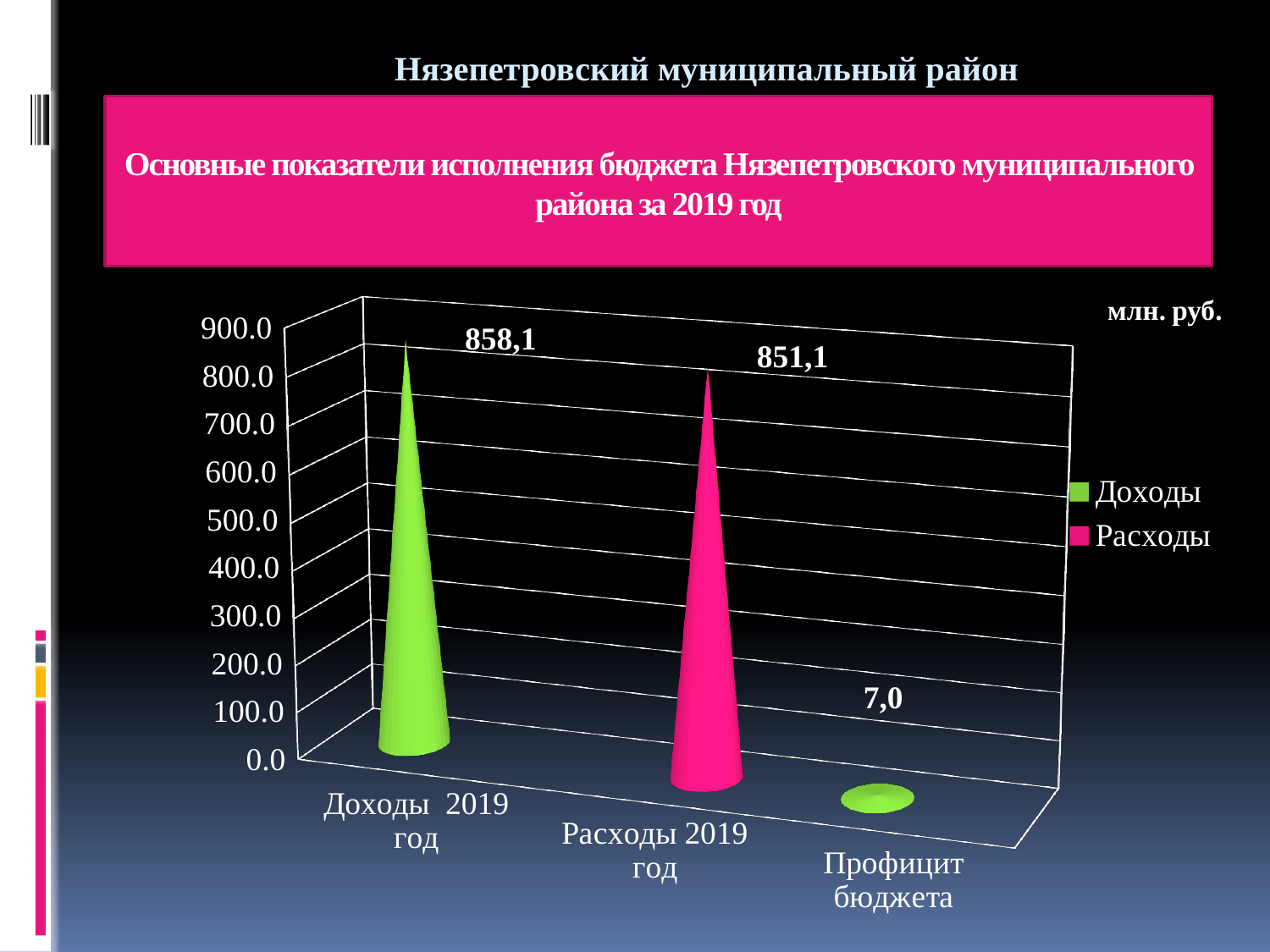
How many categories are shown on the x axis? 3 What unit of measurement is indicated for the chart values? млн. руб. What kind of chart is shown on the slide? bar chart How many series does the legend list? 2 What is the value shown for Расходы 2019 год? 851,1 What is the value shown for Профицит бюджета? 7,0 What is the difference between the values for Доходы 2019 год and Расходы 2019 год? 7,0 Which is larger, the value for Доходы 2019 год or the value for Расходы 2019 год? Доходы 2019 год Is the value for Профицит бюджета greater or less than 100.0? less Which category has the lowest value? Профицит бюджета What is the value shown for Доходы 2019 год? 858,1 Which category has the highest value? Доходы 2019 год